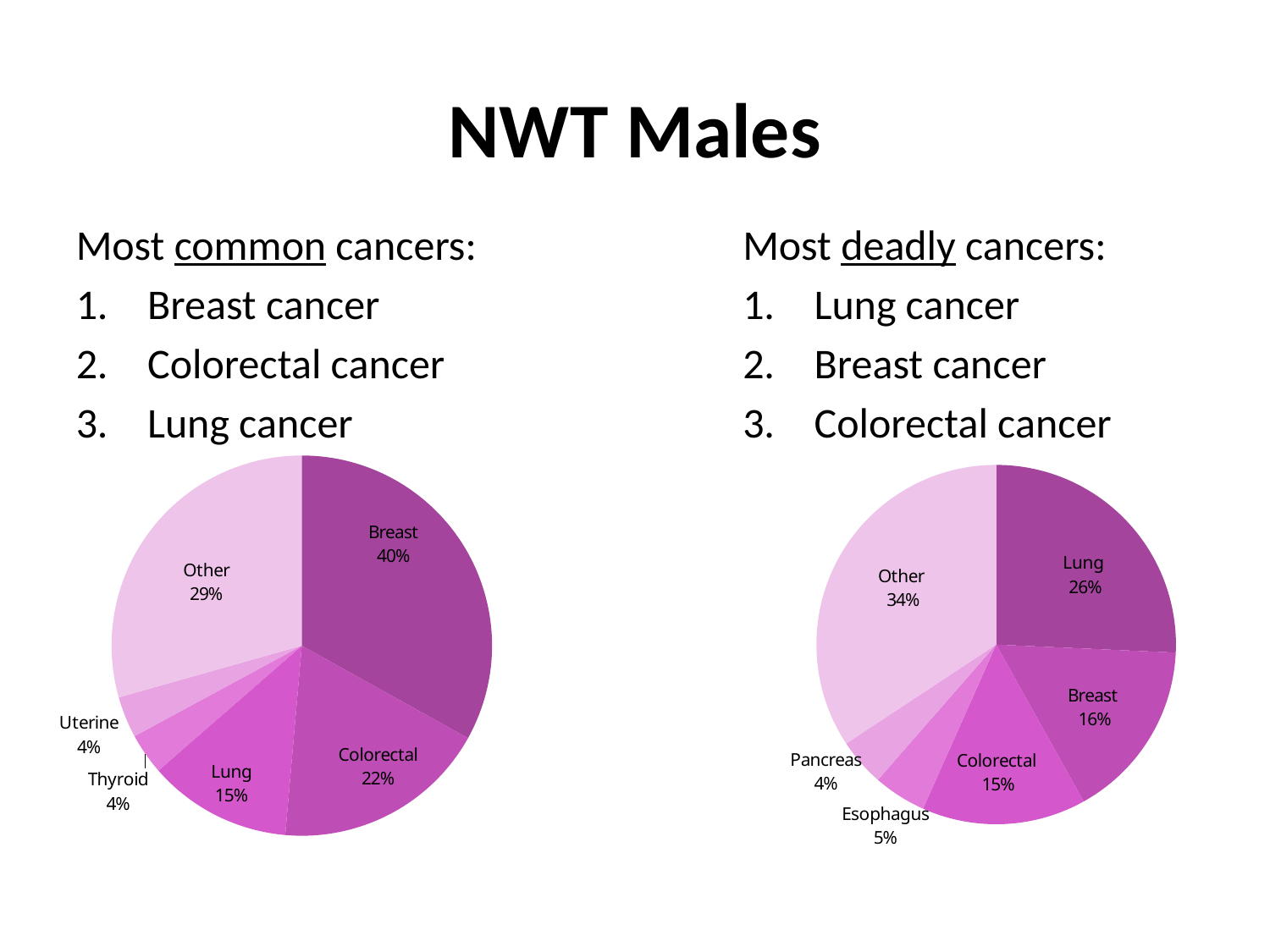
In the left pie chart (most common cancers), what share is labelled for Breast? 40% In the right pie chart (most deadly cancers), which slice is the smallest? Pancreas In the right pie chart (most deadly cancers), what is the difference between the Lung and Breast shares? 10% In the right pie chart (most deadly cancers), what share is labelled for Esophagus? 5% How many slices does the left pie chart (most common cancers) have? 6 What type of chart is used on the right side of the slide for the most deadly cancers? Pie chart In the right pie chart (most deadly cancers), what share is labelled for Lung? 26% In the left pie chart (most common cancers), what share is labelled for Colorectal? 22% In the left pie chart (most common cancers), what is the difference between the Breast and Colorectal shares? 18% In the left pie chart (most common cancers), which named cancer slice is the largest? Breast In the right pie chart (most deadly cancers), which is larger, the Breast slice or the Colorectal slice? Breast In the left pie chart (most common cancers), what share is labelled for Other? 29%